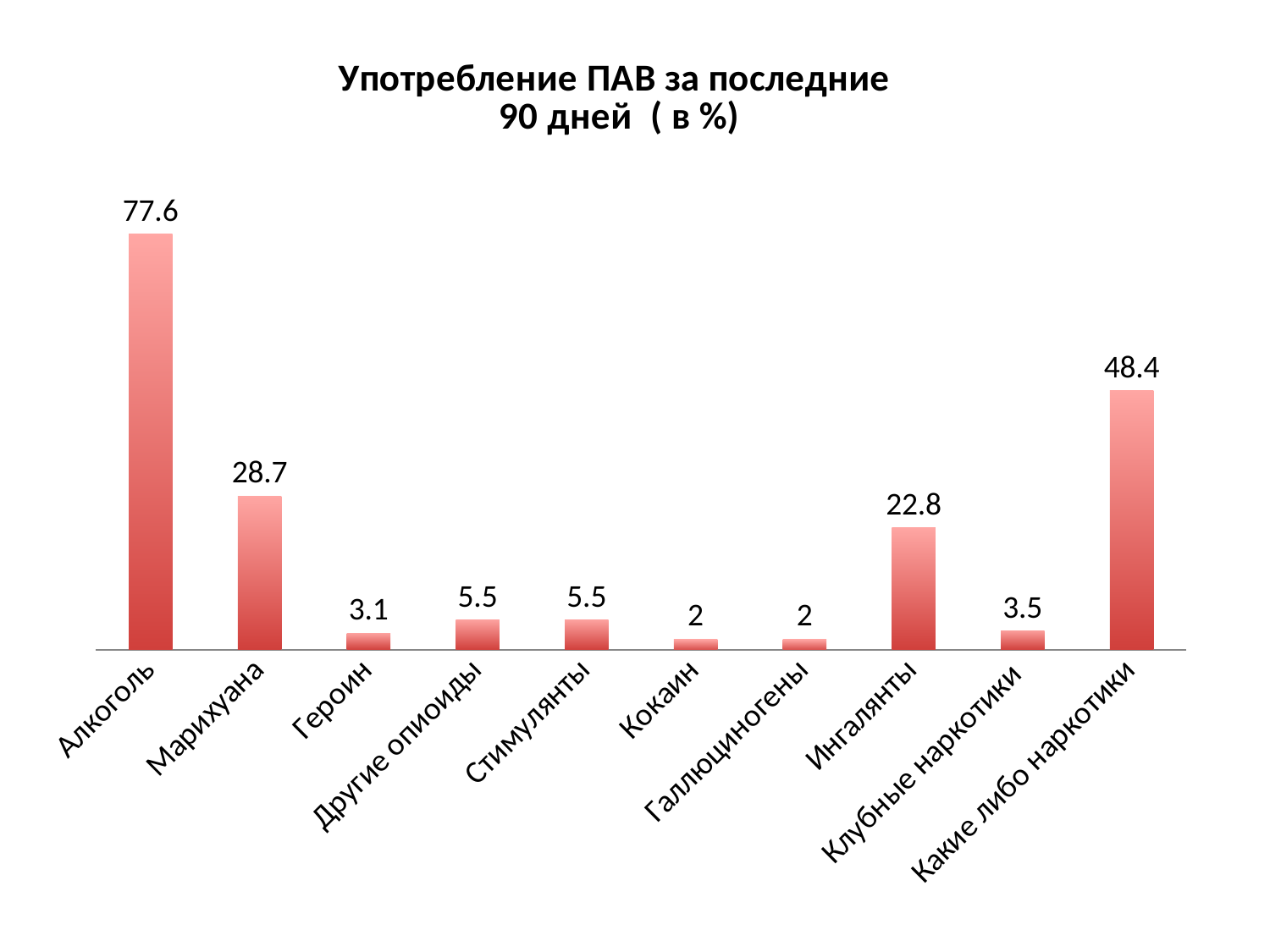
What is the value for Алкоголь? 77.6 What is the value for Какие либо наркотики? 48.4 How many categories are shown on the x axis? 10 What is the difference between the values for Алкоголь and Марихуана? 48.9 What is the value for Героин? 3.1 What is the title of the chart? Употребление ПАВ за последние 90 дней ( в %) Which is larger, the value for Клубные наркотики or the value for Другие опиоиды? Другие опиоиды Which category has the highest value? Алкоголь What is the value for Ингалянты? 22.8 What kind of chart is this? bar chart Which is larger, the value for Марихуана or the value for Ингалянты? Марихуана What is the difference between the values for Какие либо наркотики and Ингалянты? 25.6